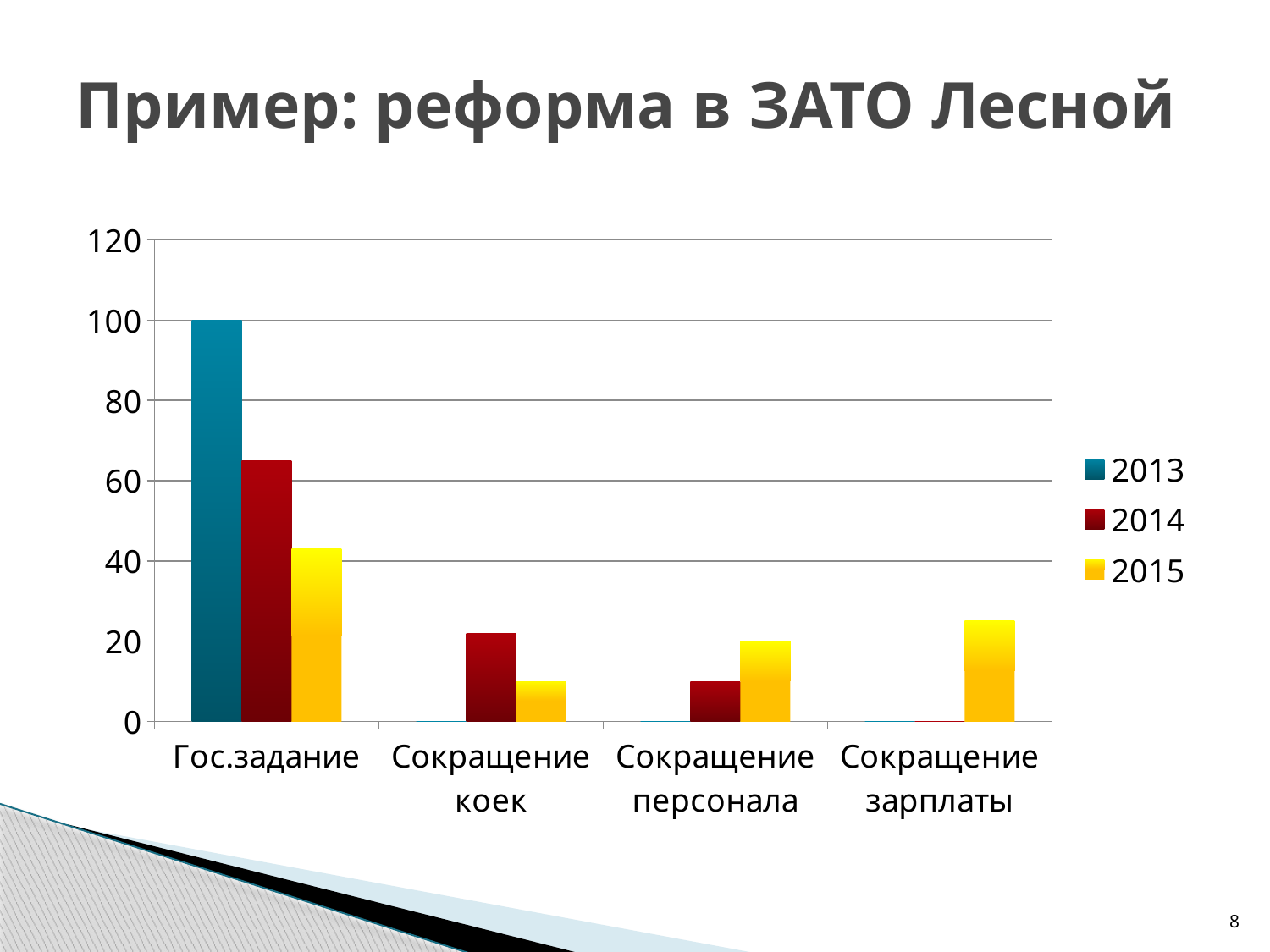
Is the 2014 value for Гос.задание greater or less than 60? greater Which category has the highest value for the 2014 series? Гос.задание How many series does the legend list? 3 In the Гос.задание category, which is larger: the 2013 value or the 2014 value? 2013 What is the value for 2013 in the Гос.задание category? 100 What is the title of the slide containing the chart? Пример: реформа в ЗАТО Лесной How many categories are shown on the x axis? 4 Is the 2015 value for Гос.задание greater or less than 60? less Do the values for Гос.задание rise or fall from 2013 to 2015? fall Is the 2015 value for Сокращение зарплаты greater or less than 20? greater In the Сокращение коек category, which is larger: the 2014 value or the 2015 value? 2014 What kind of chart is shown on the slide? bar chart